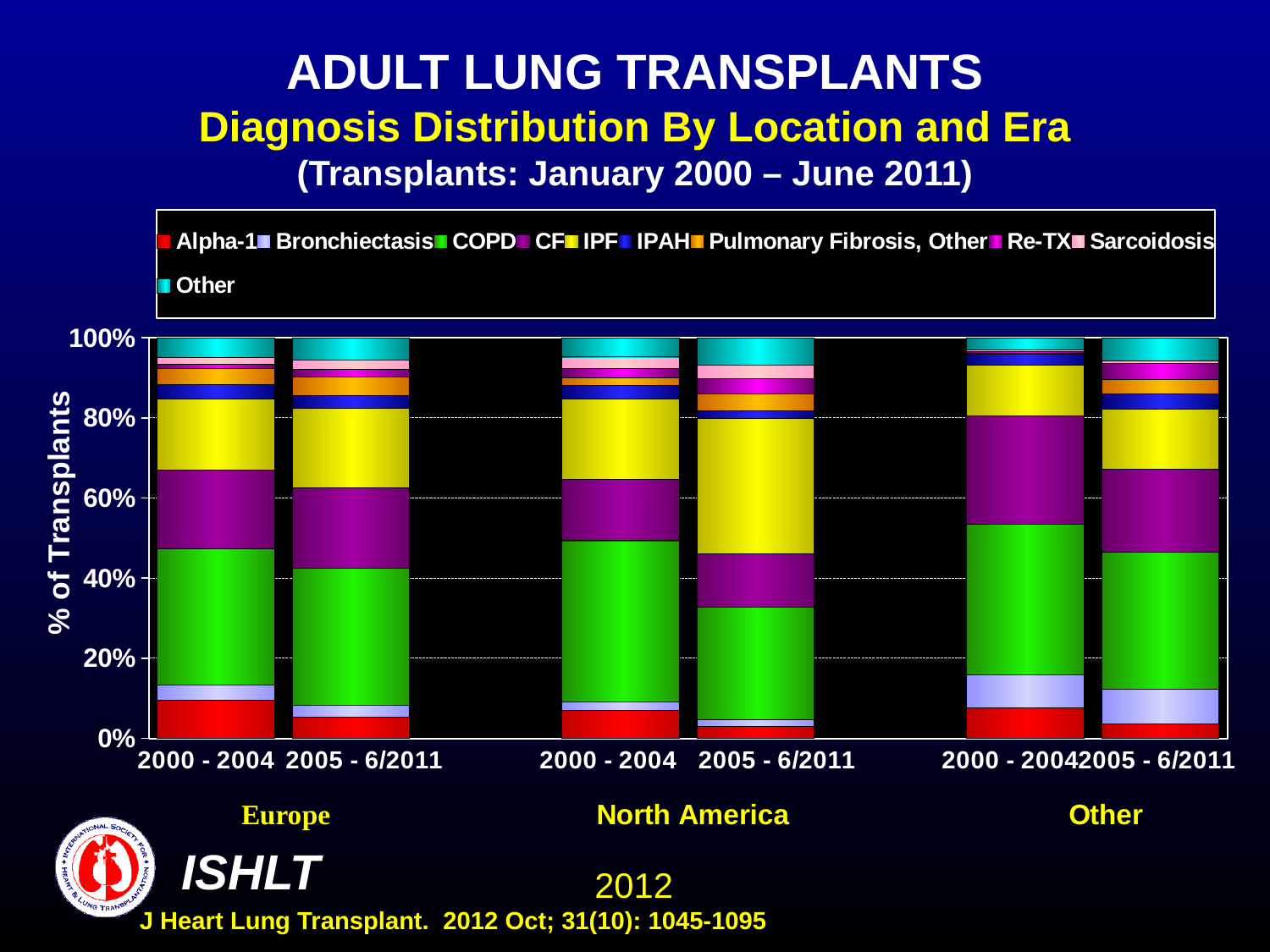
Is the COPD share for Other 2000 - 2004 greater or less than 20%? greater How many series does the legend list? 10 How many bars are plotted in the chart? 6 Does the COPD share in North America rise or fall from 2000 - 2004 to 2005 - 6/2011? fall Is the COPD share for Europe 2000 - 2004 greater or less than 20%? greater Which three locations are shown along the x axis? Europe, North America, Other In North America, is the COPD share larger in 2000 - 2004 or in 2005 - 6/2011? 2000 - 2004 Is the Alpha-1 share for Europe 2005 - 6/2011 greater or less than 20%? less In North America, is the IPF share larger in 2000 - 2004 or in 2005 - 6/2011? 2005 - 6/2011 What kind of chart is shown on the slide? Stacked bar chart What is the label of the y axis? % of Transplants